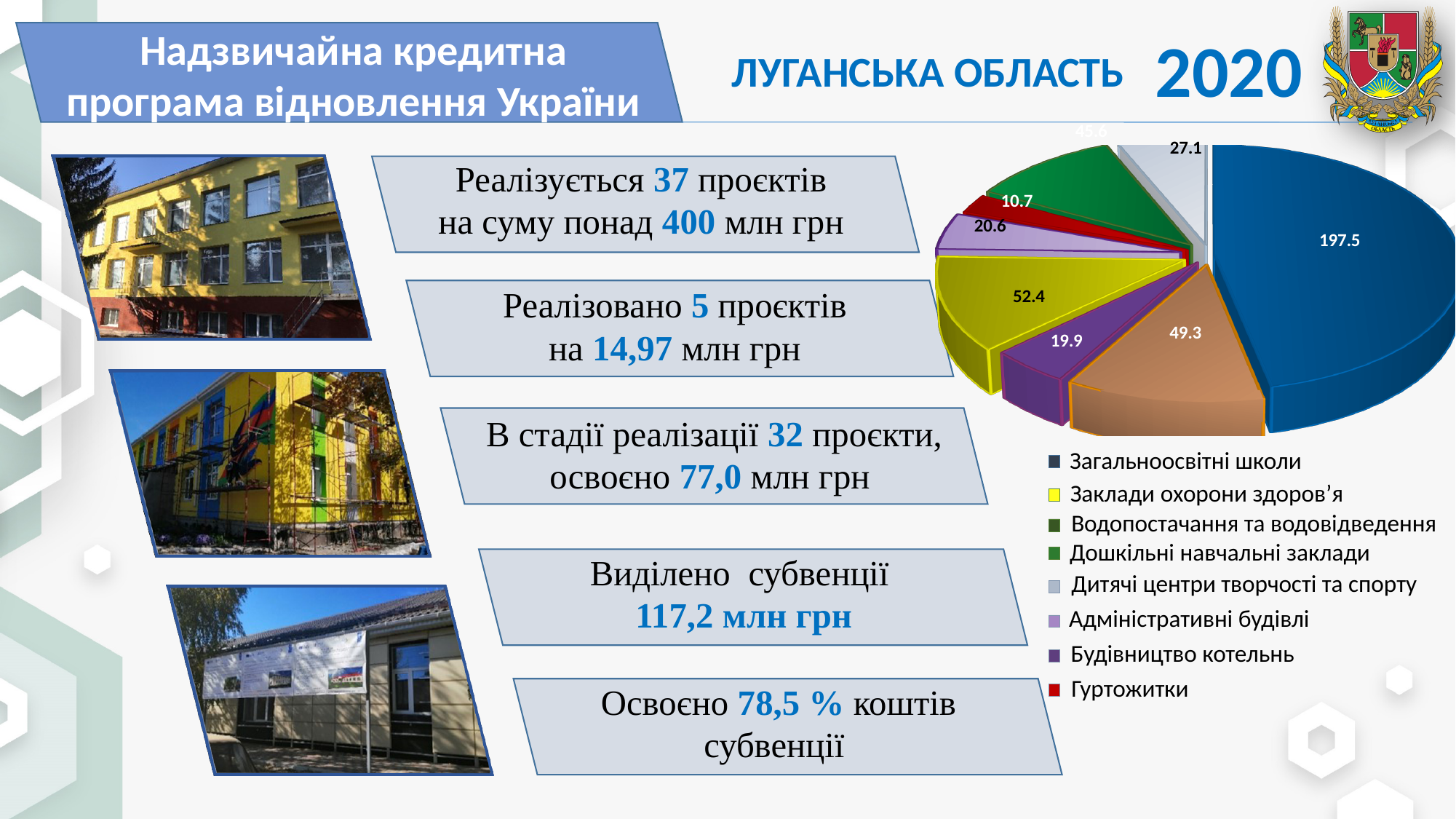
Which category has the largest slice in the pie chart? Загальноосвітні школи What is the value for Заклади охорони здоров’я in the pie chart? 52.4 What is the value for Гуртожитки in the pie chart? 10.7 How many categories does the legend of the pie chart list? 8 Which category has the smallest slice in the pie chart? Гуртожитки What is the value for Дитячі центри творчості та спорту in the pie chart? 27.1 Which is larger: the value for Заклади охорони здоров’я or the value for Адміністративні будівлі? Заклади охорони здоров’я What is the difference between the values for Загальноосвітні школи and Заклади охорони здоров’я? 145.1 What kind of chart is shown on the slide? pie chart What is the value for Адміністративні будівлі in the pie chart? 20.6 What is the value for Загальноосвітні школи in the pie chart? 197.5 What is the value for Будівництво котельнь in the pie chart? 19.9